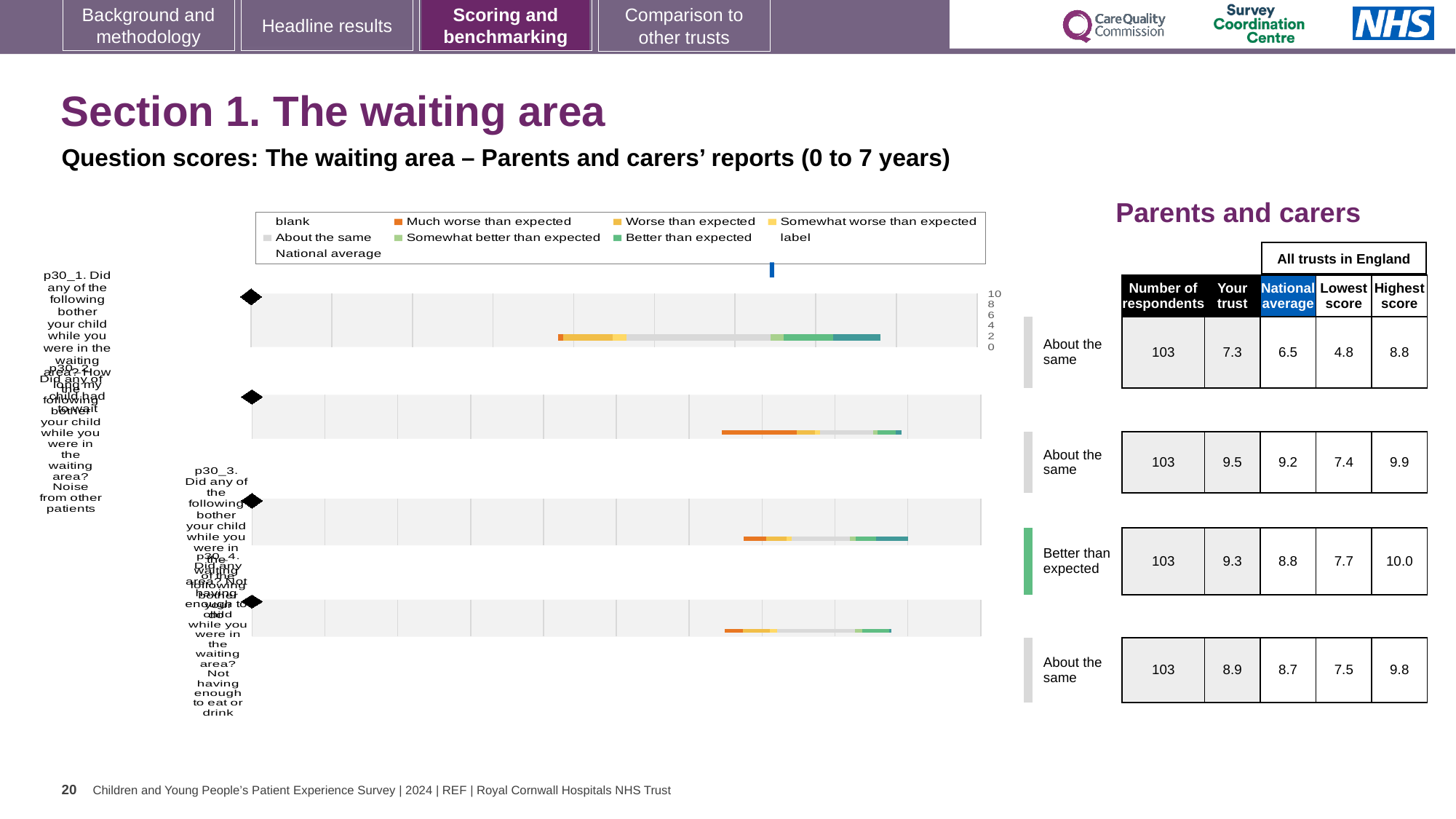
What is the highest score across all trusts in England for the third question (p30_3)? 10.0 How many respondents are listed for each question in the table? 103 For the first question (p30_1), what is the difference between the 'Your trust' score and the national average? 0.8 How many question bars are plotted in the chart? 4 Which question has the lowest 'Your trust' score in the table? p30_1 What is the lowest score across all trusts in England for the fourth question (p30_4)? 7.5 In the table next to the chart, what is the national average for the second question (p30_2)? 9.2 For the third question (p30_3), which is larger: the 'Your trust' score or the national average? Your trust What benchmark category is shown for the third question (p30_3)? Better than expected What kind of chart is shown on the slide? bar chart Which question has the highest 'Your trust' score in the table? p30_2 In the table next to the chart, what is the 'Your trust' score for the first question (p30_1)? 7.3